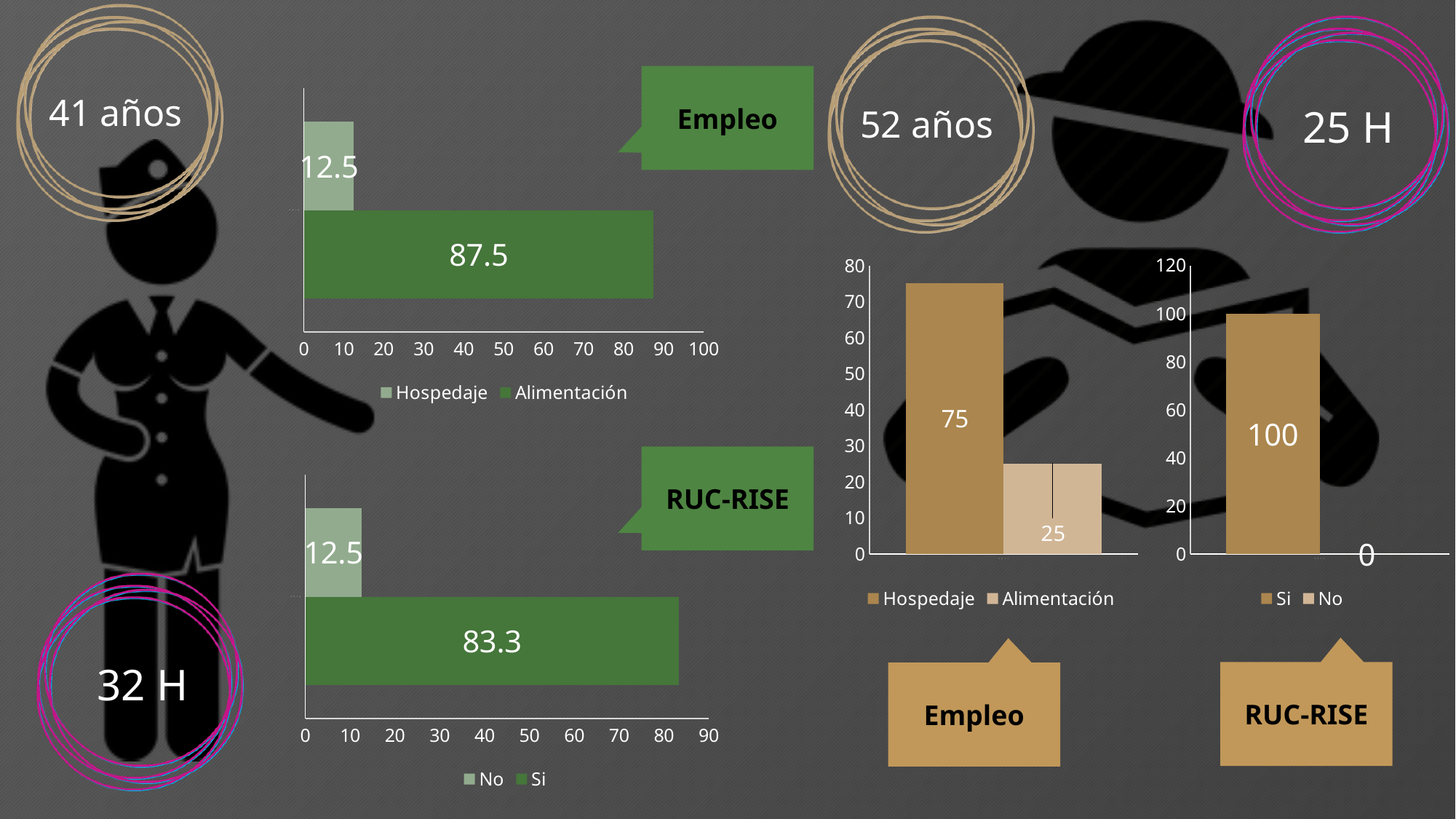
In the brown RUC-RISE chart at the far right, what is the value for No? 0 In the green RUC-RISE chart at the bottom left, what is the value for Si? 83.3 In the green RUC-RISE chart at the bottom left, what kind of chart is shown? Bar chart In the green Empleo chart on the left, what is the value for Hospedaje? 12.5 In the brown Empleo chart on the right, which series has the lowest value? Alimentación In the green Empleo chart on the left, what is the value for Alimentación? 87.5 In the brown Empleo chart on the right, what is the value for Alimentación? 25 How many series does the legend of the brown RUC-RISE chart at the far right list? 2 In the green RUC-RISE chart at the bottom left, which series has the larger value, No or Si? Si In the green Empleo chart on the left, what is the difference between the Alimentación and Hospedaje values? 75 In the brown RUC-RISE chart at the far right, what is the value for Si? 100 In the brown Empleo chart on the right, what is the value for Hospedaje? 75